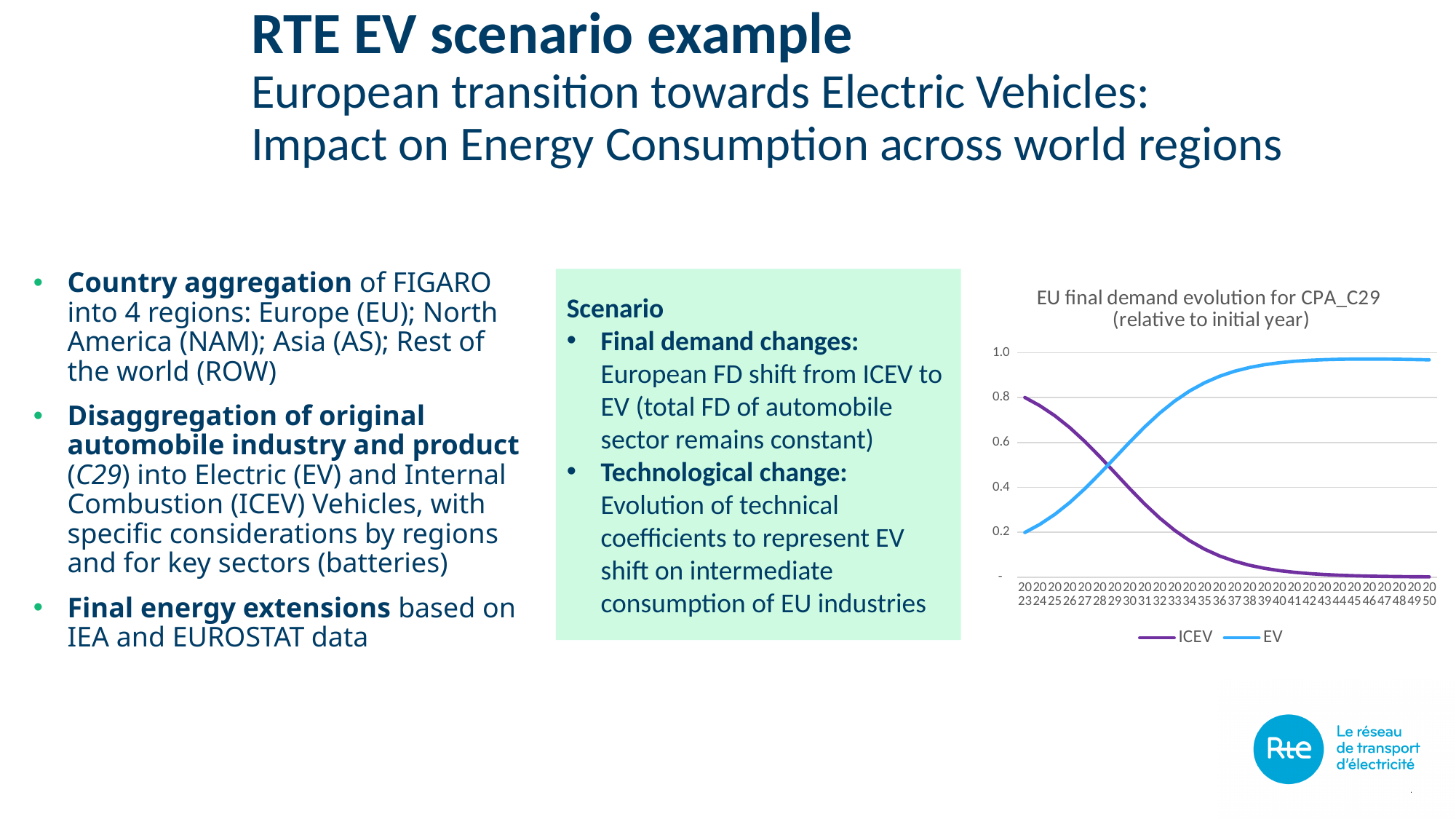
Is the ICEV value in 2023 greater or less than 0.6? greater How many years are shown along the x axis of the chart? 28 Does the EV series rise or fall from 2023 to 2050? Rise Is the EV value in 2050 greater or less than 0.8? greater Is the ICEV value in 2050 greater or less than 0.2? less Does the ICEV series rise or fall from 2023 to 2050? Fall How many series does the chart legend list? 2 In 2040, which series has the higher value, ICEV or EV? EV What is the title of the chart? EU final demand evolution for CPA_C29 (relative to initial year) Which two series are shown in the chart legend? ICEV and EV What kind of chart is shown on the slide? Line chart